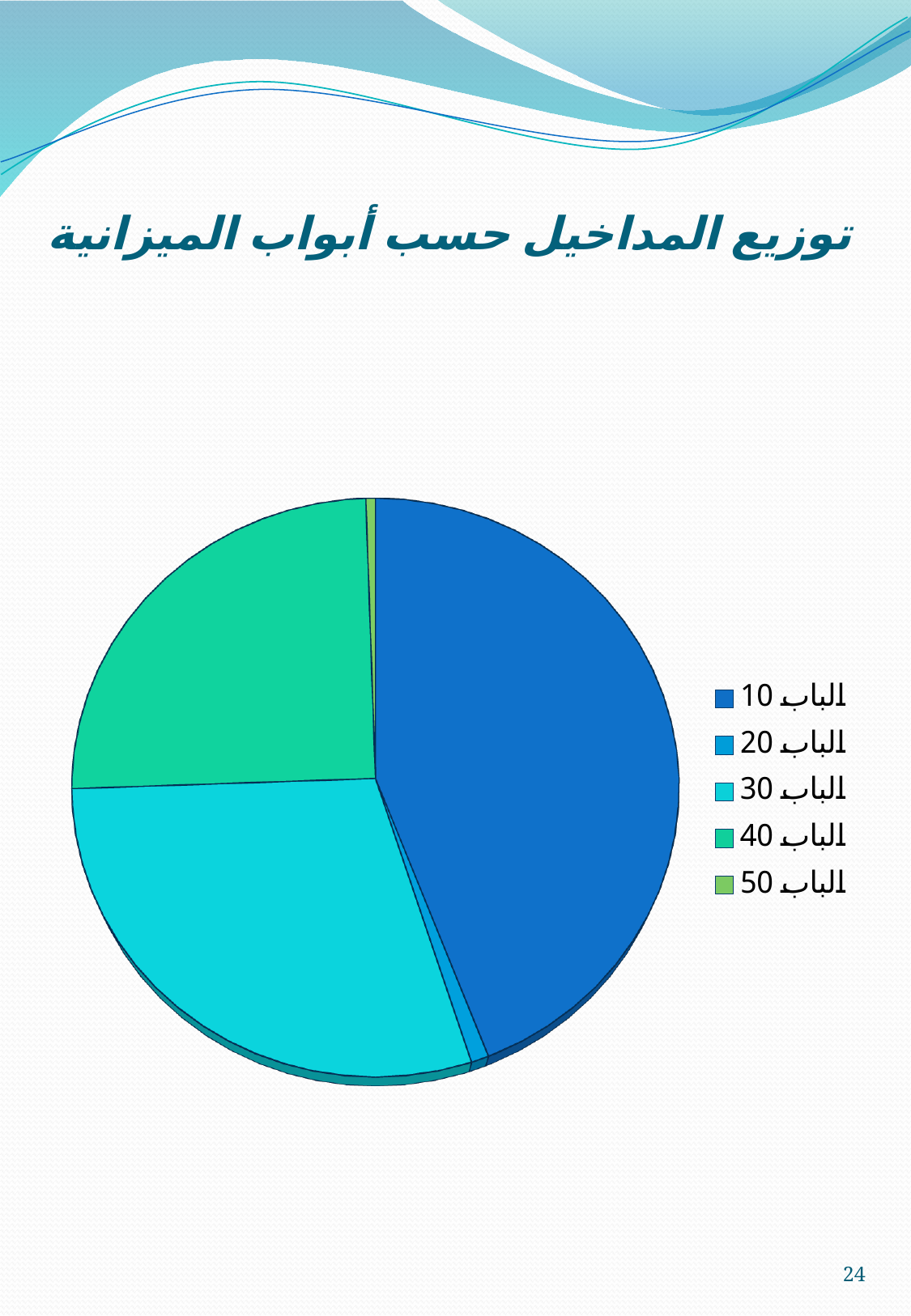
What is the title of the slide containing the pie chart? توزيع المداخيل حسب أبواب الميزانية Which slice is larger, الباب 10 or الباب 30? الباب 10 Which legend entry is listed first in the pie chart's legend? الباب 10 Which slice is larger, الباب 30 or الباب 50? الباب 30 Which category has the smallest slice of the pie chart? الباب 50 Which category has the largest slice of the pie chart? الباب 10 Which slice is larger, الباب 40 or الباب 20? الباب 40 What kind of chart is shown on the slide? pie chart How many slices does the pie chart have? 5 How many entries does the legend of the pie chart list? 5